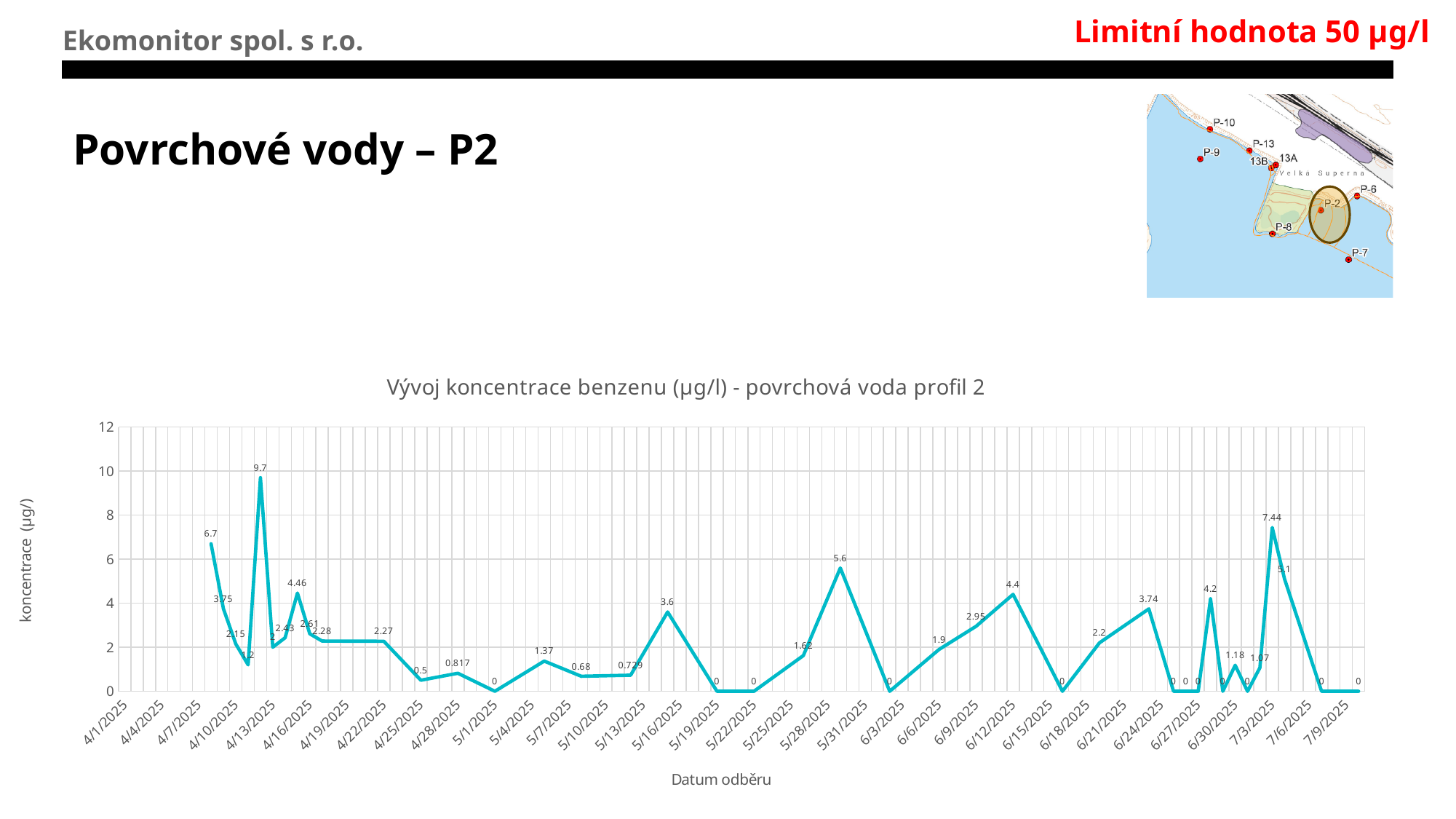
What is the title of the chart? Vývoj koncentrace benzenu (µg/l) - povrchová voda profil 2 What is the benzene concentration on 6/12/2025? 4.4 What is the benzene concentration on 7/3/2025? 7.44 What is the highest benzene concentration value plotted on the chart? 9.7 What kind of chart is shown on the slide? line chart What is the label of the vertical axis of the chart? koncentrace (µg/l) What is the lowest value plotted on the chart? 0